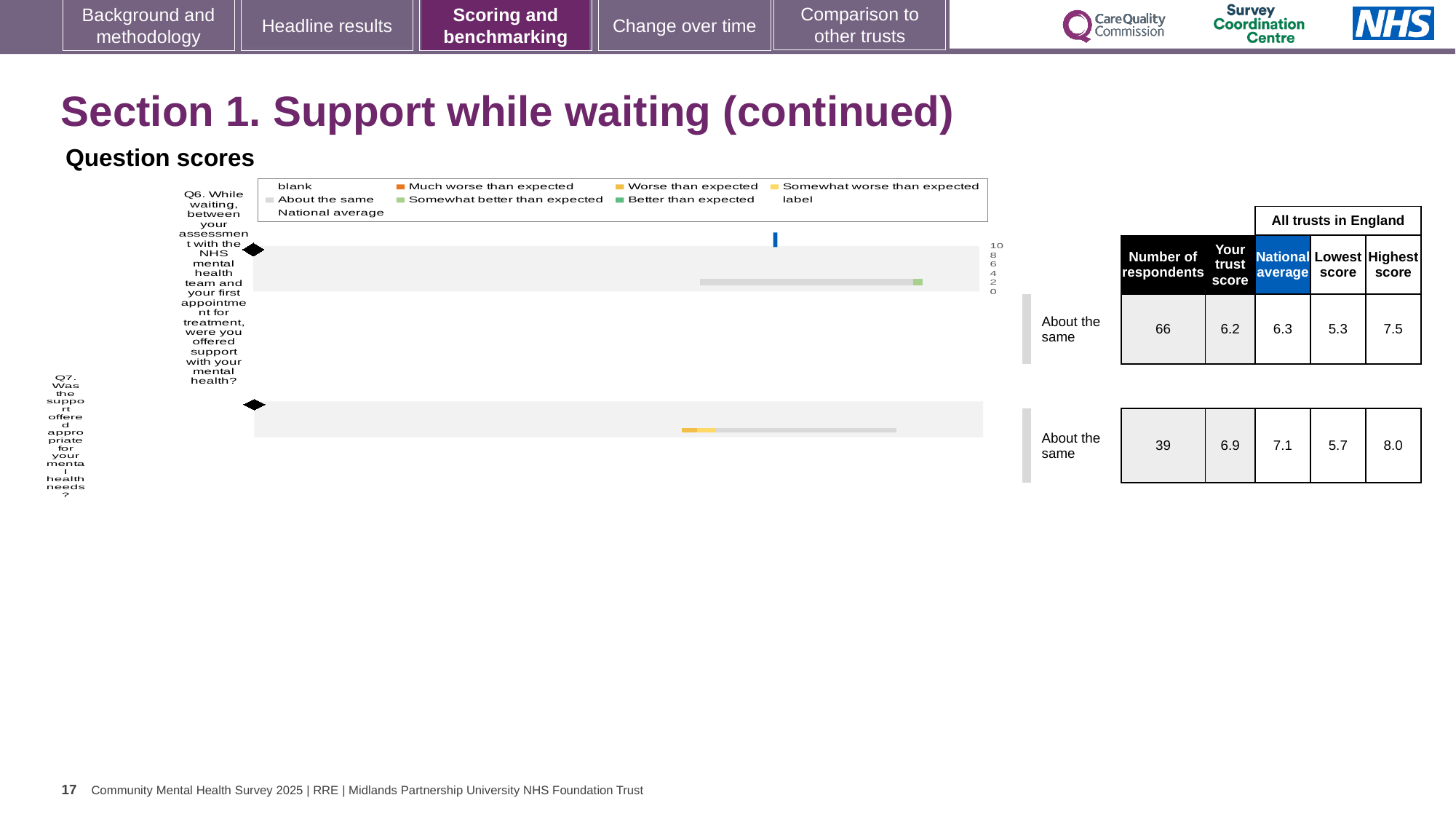
How many questions (categories) are plotted in the Question scores chart? 2 What is the trust score for Q6 in the Question scores chart? 6.2 What kind of chart is shown under 'Question scores'? bar chart Which question has the higher trust score, Q6 or Q7? Q7 What is the trust score for Q7 in the Question scores chart? 6.9 What is the national average for Q6 in the Question scores chart? 6.3 What is the difference between the highest score and the lowest score for Q7? 2.3 How many entries does the legend of the Question scores chart list? 9 Is the trust score for Q6 greater or less than 8? less What is the highest value shown on the axis of the Question scores chart? 10 What is the number of respondents for Q7 in the Question scores chart? 39 Which legend entry in the Question scores chart is shown in grey? About the same